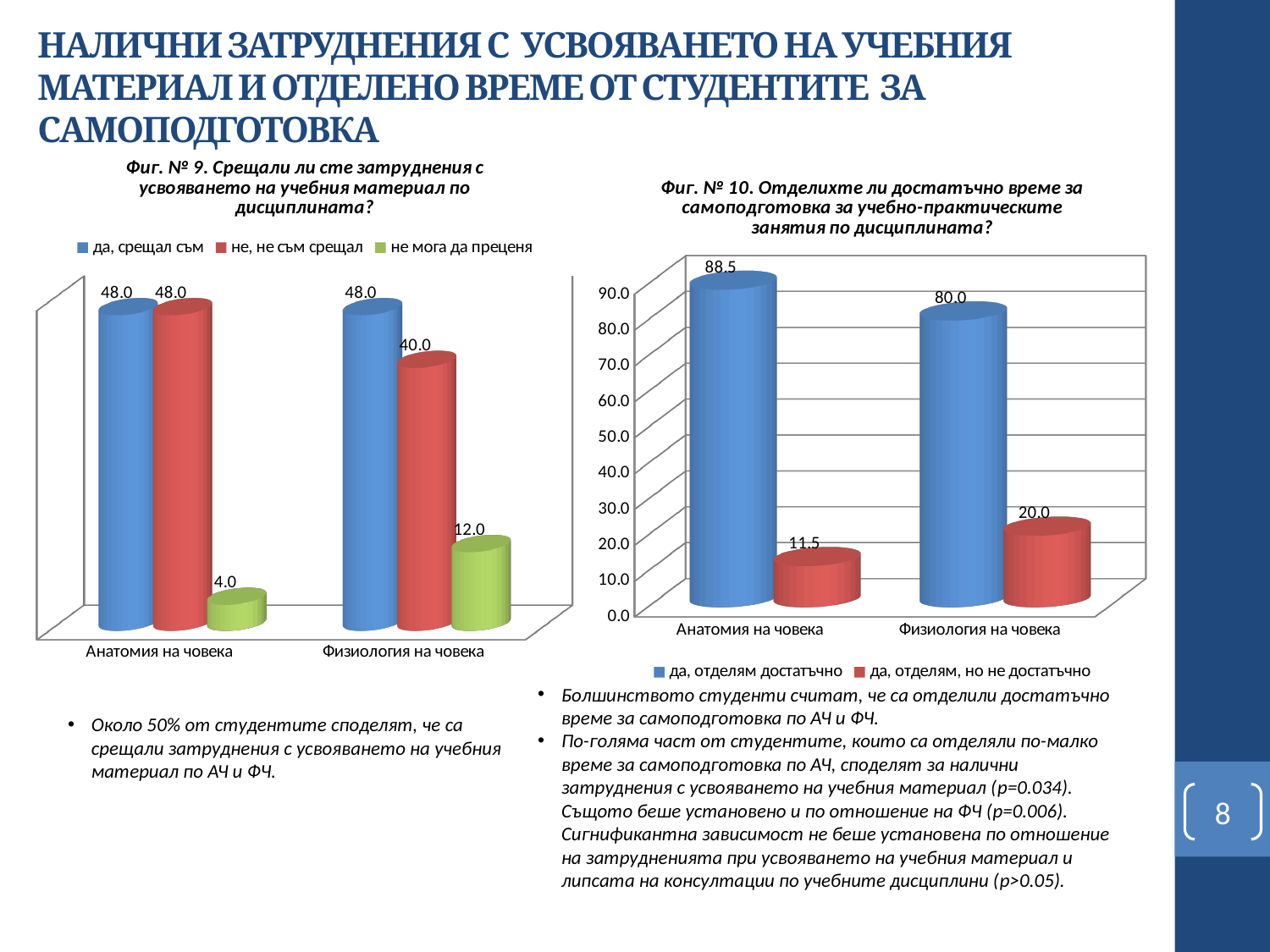
In Фиг. № 10, which category has the higher value for "да, отделям, но не достатъчно"? Физиология на човека How many categories are shown on the x axis of Фиг. № 10? 2 In Фиг. № 9, which series has the lowest value for Физиология на човека? не мога да преценя In Фиг. № 9, what is the difference between "не мога да преценя" for Физиология на човека and for Анатомия на човека? 8.0 What kind of chart is Фиг. № 10? bar chart In Фиг. № 10, is the value for "да, отделям достатъчно" for Физиология на човека greater or less than 70.0? greater In Фиг. № 9, what is the value for "не, не съм срещал" for Физиология на човека? 40.0 In Фиг. № 10, what is the value for "да, отделям достатъчно" for Анатомия на човека? 88.5 In Фиг. № 9, how many series does the legend list? 3 In Фиг. № 9, what is the value for "не мога да преценя" for Анатомия на човека? 4.0 In Фиг. № 10, what is the difference between "да, отделям достатъчно" for Анатомия на човека and for Физиология на човека? 8.5 In Фиг. № 10, what is the value for "да, отделям, но не достатъчно" for Физиология на човека? 20.0